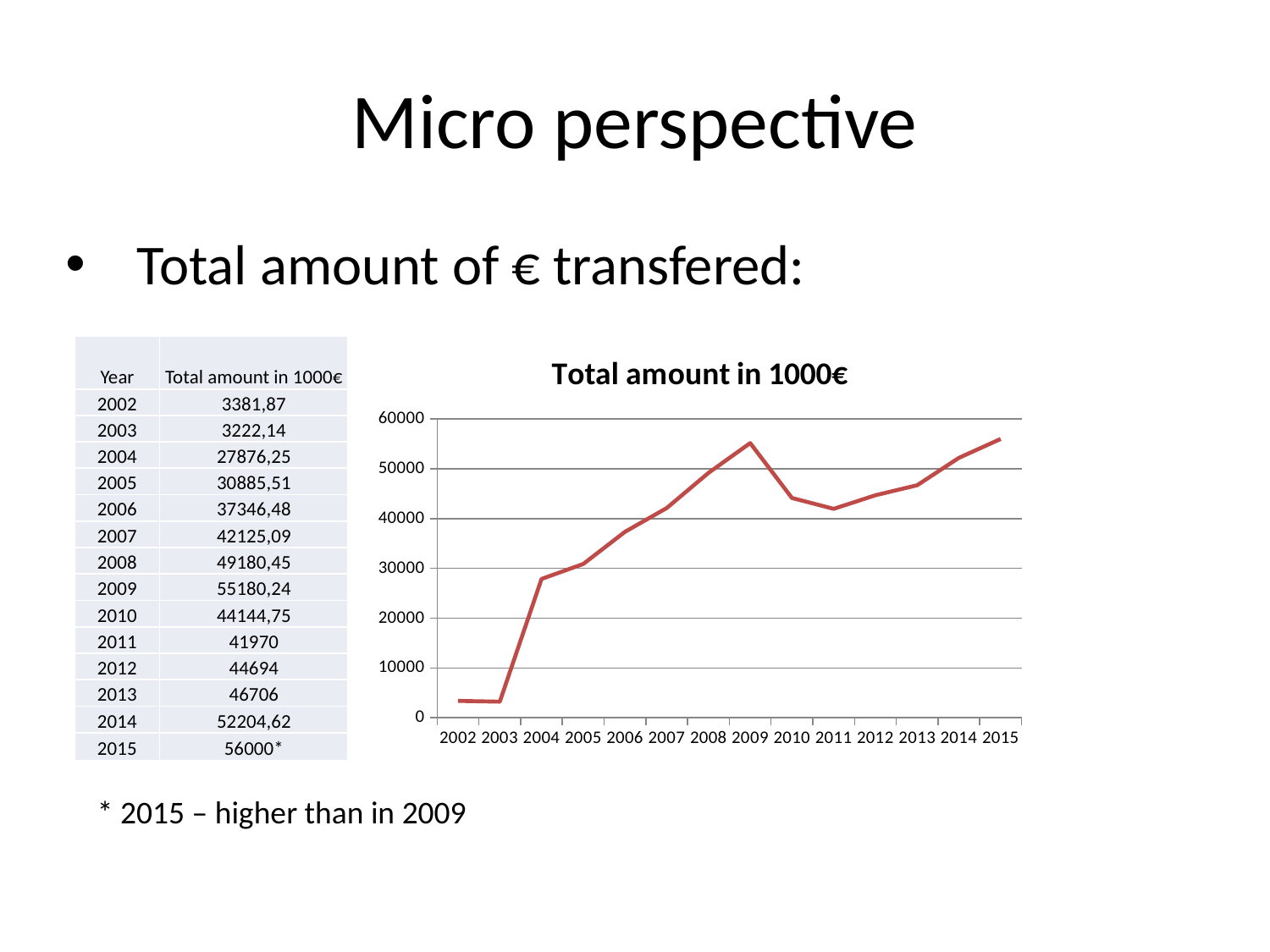
Does the value rise or fall from 2009 to 2011? fall What is the title of the chart? Total amount in 1000€ What is the total amount in 1000€ for 2004? 27876,25 Which year has the lowest value in the chart? 2003 Which is larger, the value for 2009 or the value for 2010? 2009 What is the total amount in 1000€ for 2009? 55180,24 What is the total amount in 1000€ for 2011? 41970 What kind of chart is shown on the slide? line chart Is the value for 2003 greater or less than 10000? less Is the value for 2010 greater or less than 40000? greater How many years are plotted along the x axis of the chart? 14 Which year has the highest value in the chart? 2015